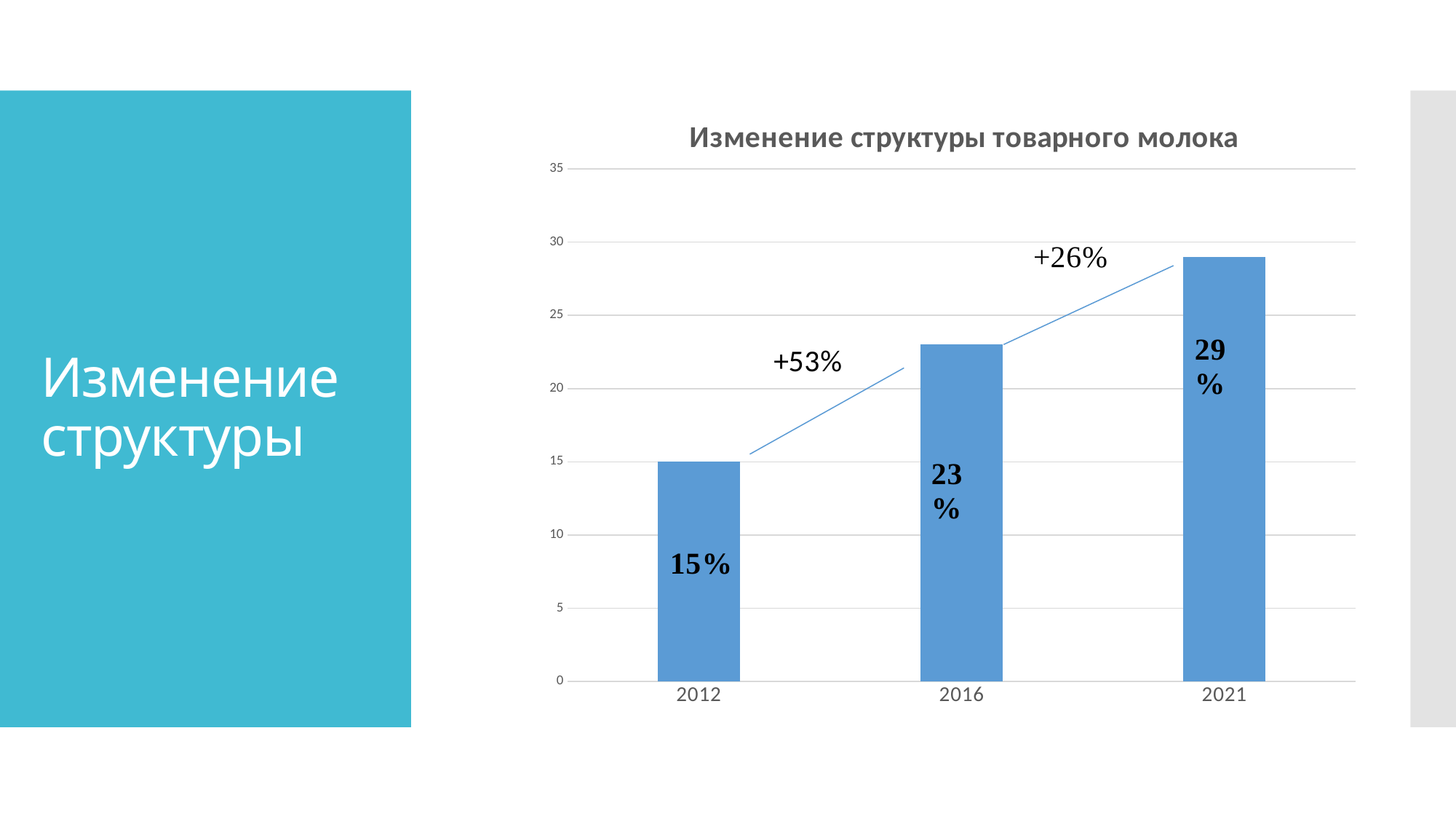
What is the difference between the values for 2021 and 2012? 14% What is the value for 2016? 23% What is the difference between the values for 2016 and 2012? 8% Do the values rise or fall from 2012 to 2021? Rise What kind of chart is shown on the slide? Bar chart Which year has the highest value? 2021 How many years are shown on the x axis? 3 What is the value for 2012? 15% Which year has the lowest value? 2012 Which is larger, the value for 2016 or the value for 2021? 2021 What is the value for 2021? 29% Is the value for 2021 greater or less than 25? greater